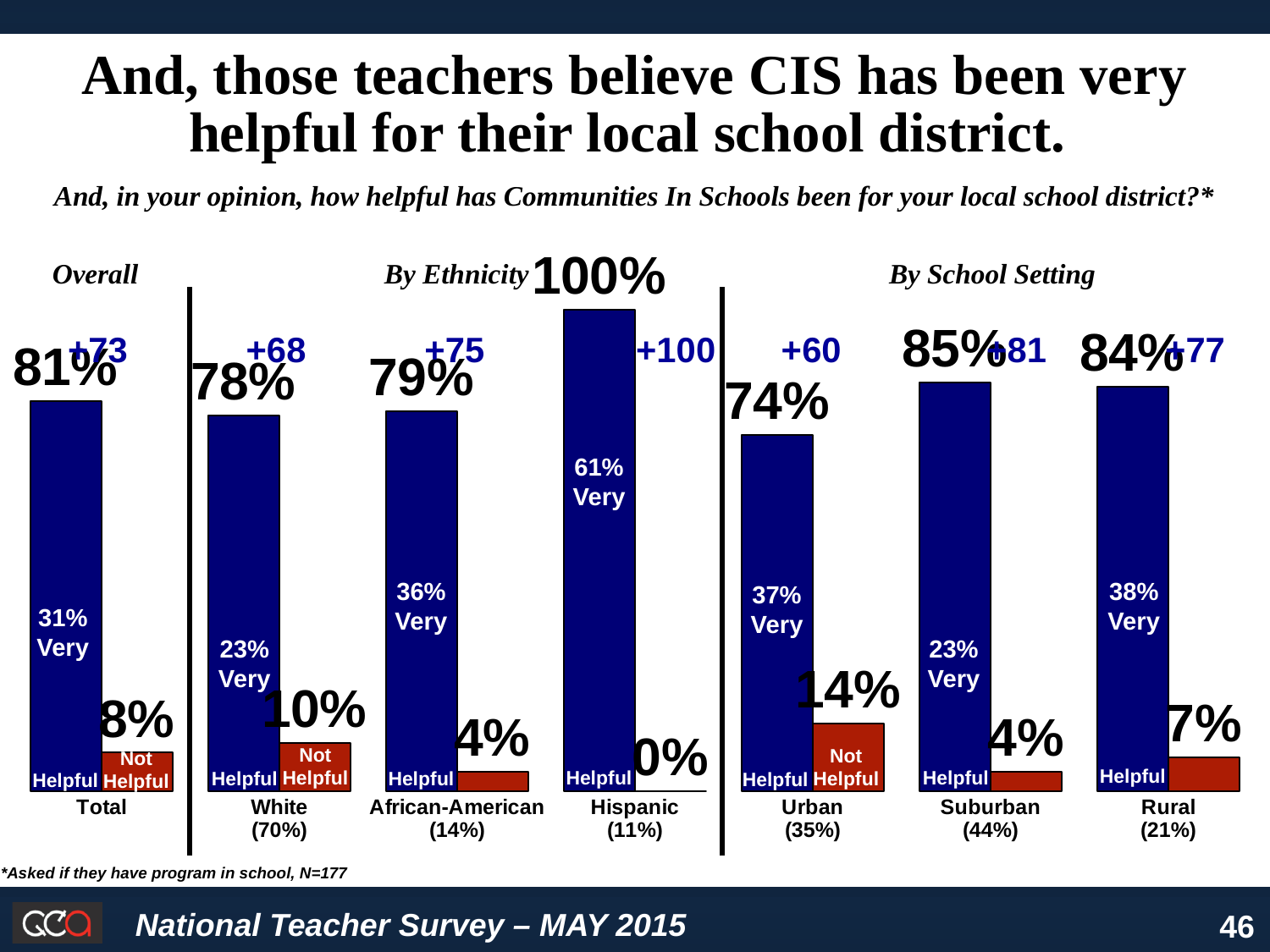
In the By School Setting chart, what is the difference between the Helpful percentages for Suburban and Urban? 11% In the By Ethnicity chart, what is the net score shown above the White bars? +68 In the Overall chart, what percentage of the Total said CIS was not helpful? 8% In the By Ethnicity chart, which group has the lowest Not Helpful percentage? Hispanic In the By Ethnicity chart, which is larger, the Not Helpful percentage for White or for African-American? White In the By School Setting chart, which setting has the highest Helpful percentage? Suburban What share of the sample is Suburban, as shown under the Suburban label? 44% In the By School Setting chart, what percentage of Urban teachers said CIS was very helpful? 37% What kind of chart is used on this slide? Bar chart How many school settings are shown in the By School Setting chart? 3 In the By Ethnicity chart, what percentage of Hispanic teachers said CIS was helpful? 100% In the By School Setting chart, what is the Not Helpful percentage for Rural? 7%